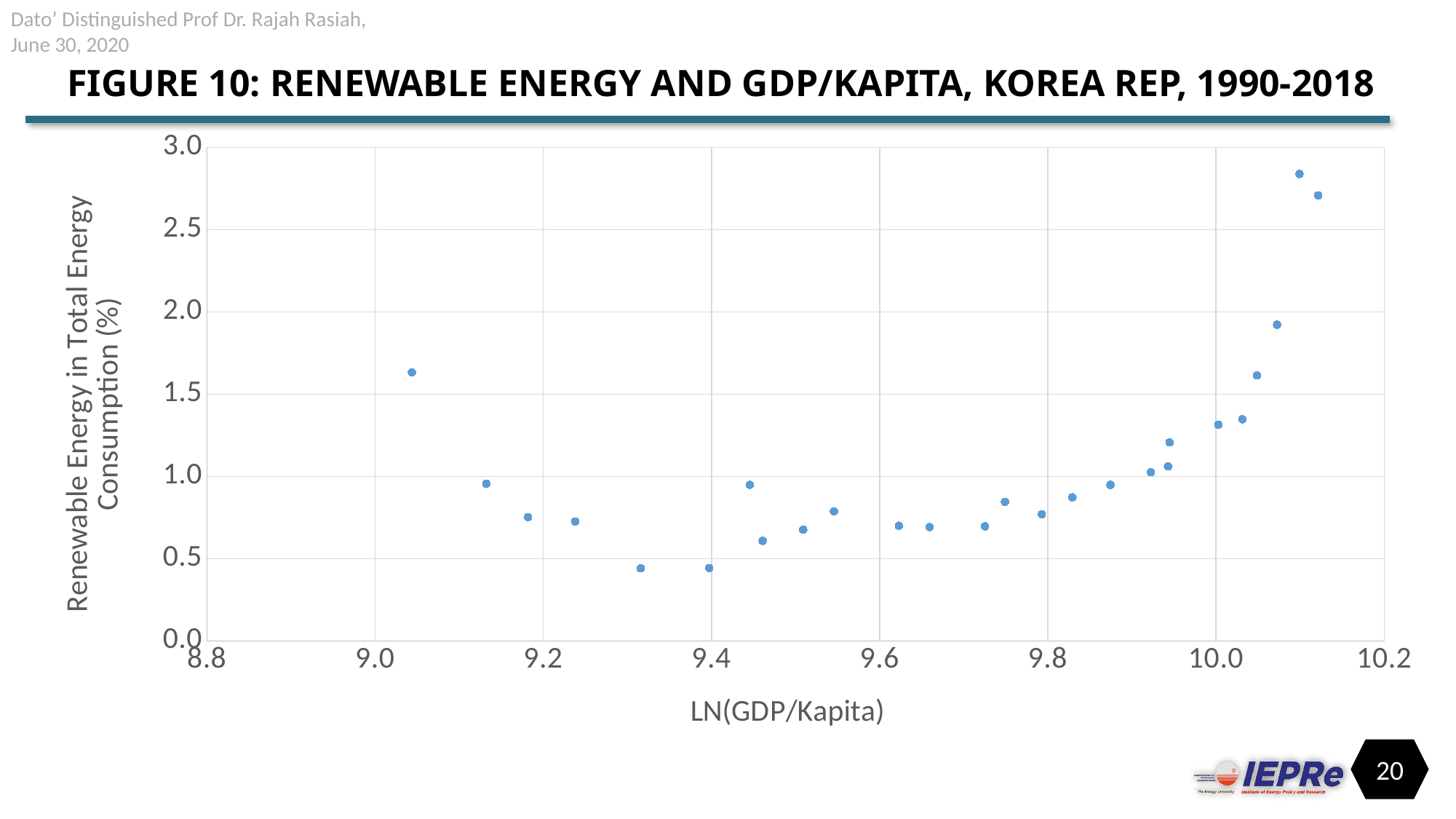
Is the renewable energy share for the point at LN(GDP/Kapita) around 9.62 greater or less than 1.0? less What is the title of the chart? FIGURE 10: RENEWABLE ENERGY AND GDP/KAPITA, KOREA REP, 1990-2018 Which point has the highest renewable energy share: the one at LN(GDP/Kapita) around 10.10 or the one around 10.07? The one around 10.10 Do the renewable energy share values rise or fall as LN(GDP/Kapita) increases from about 9.8 to 10.1? rise What is the label of the x axis? LN(GDP/Kapita) Is the renewable energy share for the point at LN(GDP/Kapita) around 10.0 greater or less than 1.0? greater Is the renewable energy share for the point with the highest LN(GDP/Kapita) (around 10.12) greater or less than 2.5? greater What kind of chart is shown on the slide? Scatter chart Which has the higher renewable energy share: the leftmost point (around 9.04) or the point at around 9.40? The leftmost point (around 9.04) Do the renewable energy share values rise or fall as LN(GDP/Kapita) increases from about 9.0 to 9.3? fall